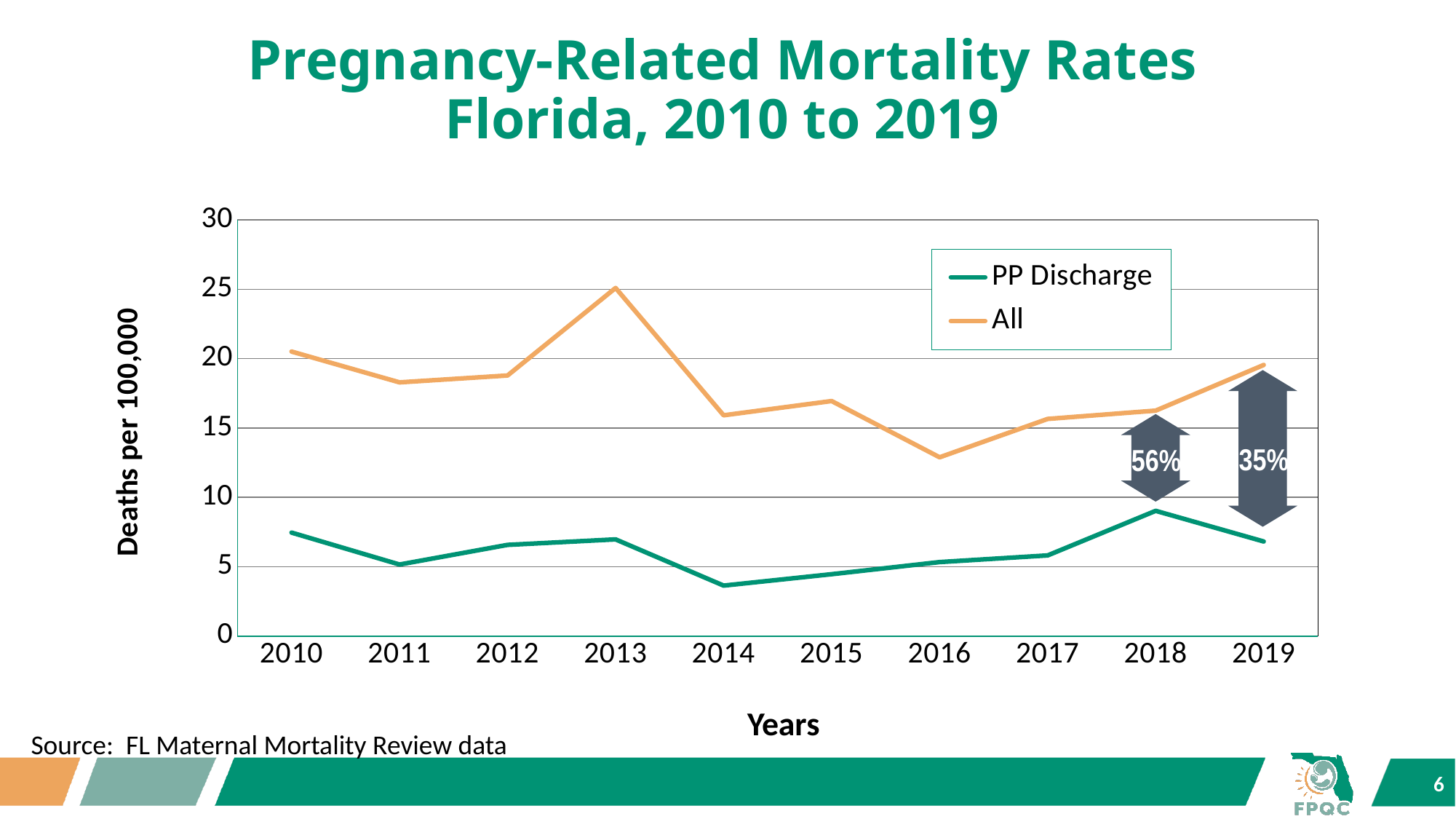
Does the All series rise or fall from 2016 to 2019? rise Is the value for All in 2016 greater or less than 15? less Is the value for PP Discharge in 2018 greater or less than 10? less How many years are plotted along the x axis? 10 How many series does the legend list? 2 What kind of chart is shown on the slide? line chart In which year is the All series at its lowest? 2016 What is the label on the y axis? Deaths per 100,000 In which year is the PP Discharge series at its highest? 2018 Is the value for All in 2013 greater or less than 20? greater In which year is the All series at its highest? 2013 In which year is the PP Discharge series at its lowest? 2014